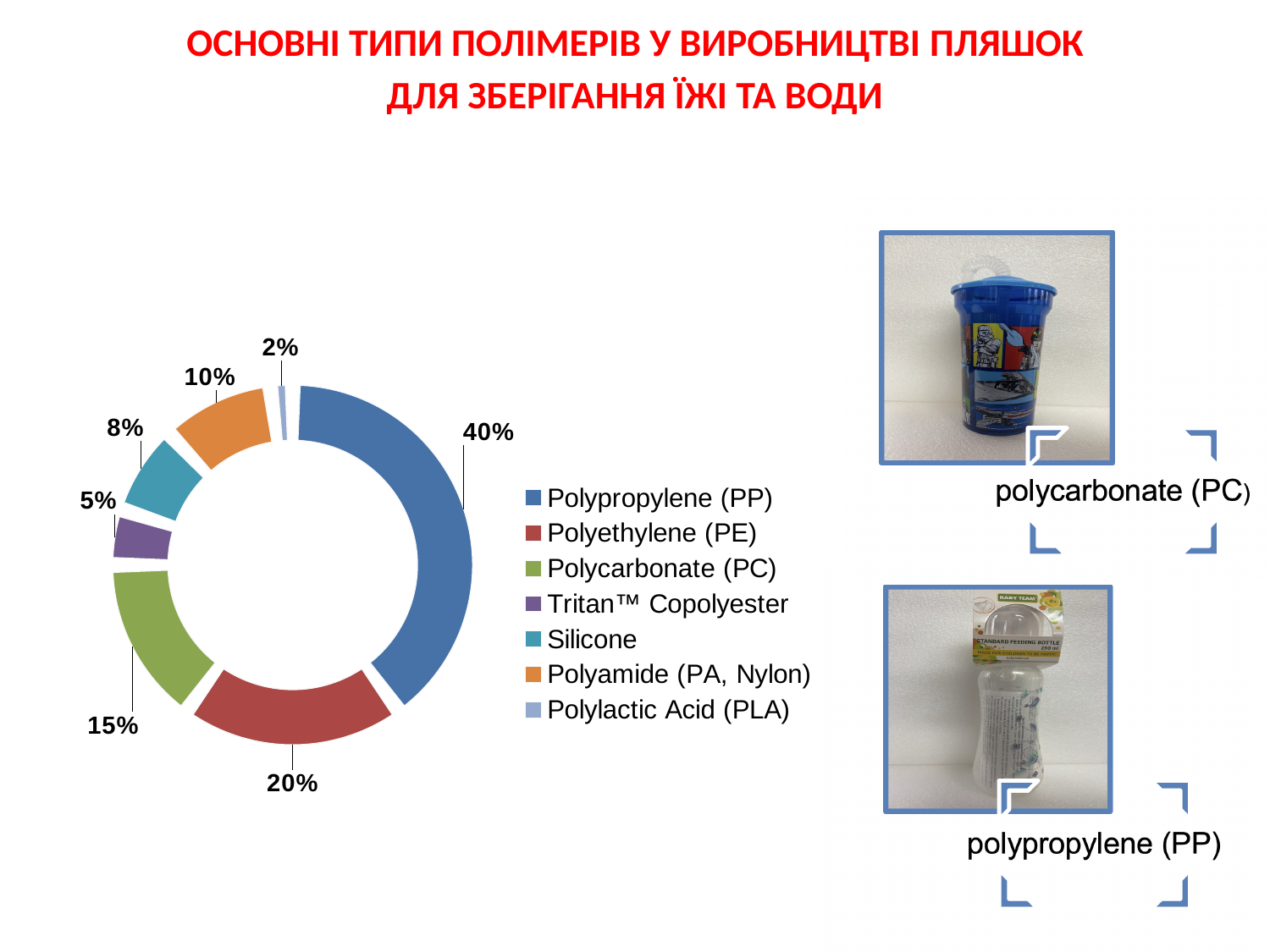
What percentage is shown for Polycarbonate (PC)? 15% Which has a larger share, Silicone or Tritan™ Copolyester? Silicone Which category has the smallest share of the chart? Polylactic Acid (PLA) What colour is the slice for Polyamide (PA, Nylon)? Orange What is the value shown for Polyethylene (PE)? 20% What share of the pie does Polypropylene (PP) have? 40% What is the difference between the shares of Polypropylene (PP) and Polyethylene (PE)? 20% What is the value for Polyamide (PA, Nylon)? 10% Which category has the largest share of the chart? Polypropylene (PP) What kind of chart is shown on the slide? Pie (doughnut) chart What is the value for Silicone? 8% How many categories does the chart show? 7